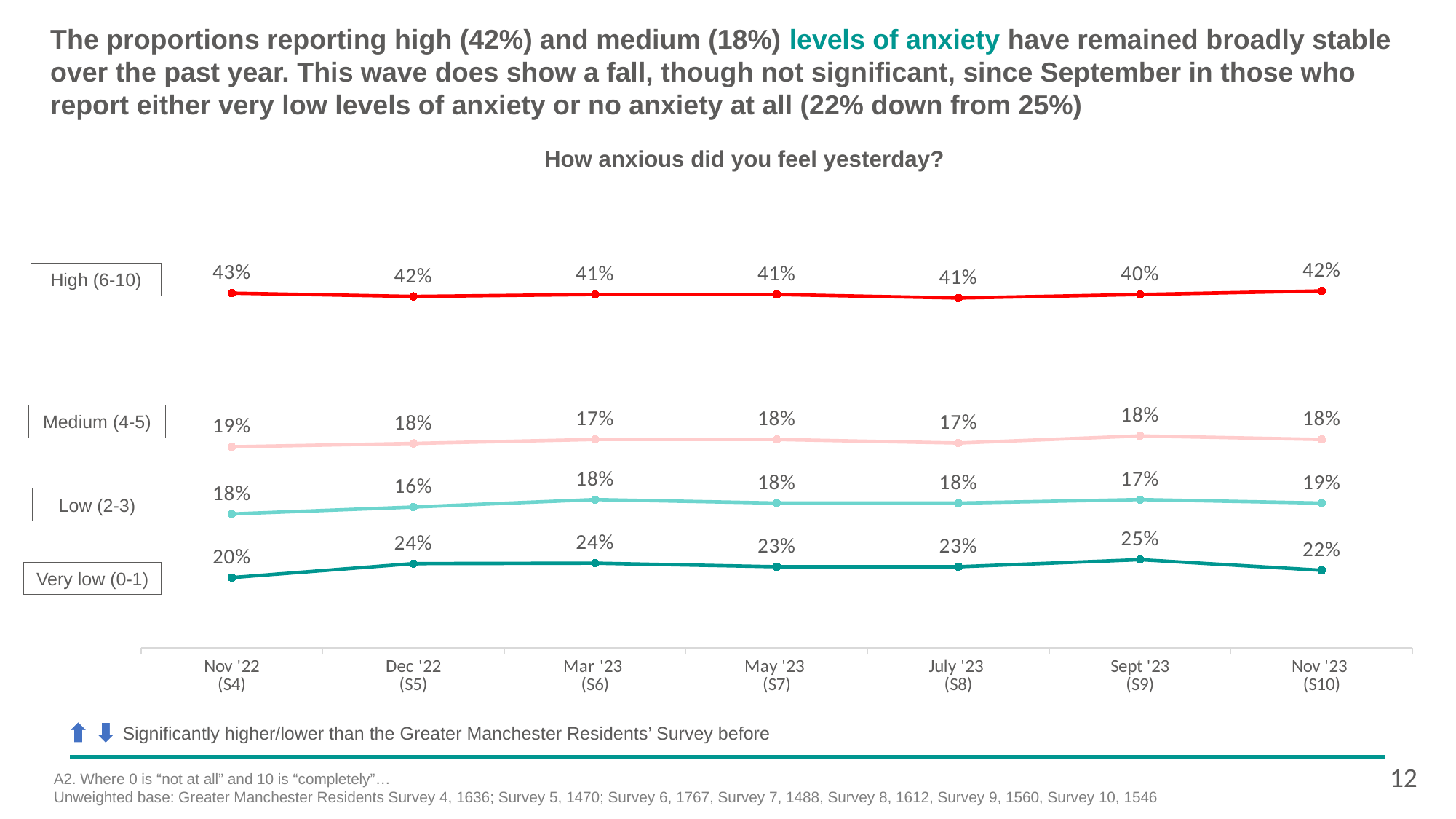
How many survey waves are shown on the x axis? 7 In which survey wave was the High (6-10) series at its lowest value? Sept '23 (S9) In which survey wave was the Very low (0-1) series at its highest value? Sept '23 (S9) Which is larger in Nov '22 (S4): the Very low (0-1) value or the Low (2-3) value? Very low (0-1) What percentage reported Low (2-3) anxiety in Dec '22 (S5)? 16% What type of chart is shown? Line chart How many series are plotted on the chart? 4 What percentage reported Very low (0-1) anxiety in Sept '23 (S9)? 25% What percentage reported High (6-10) anxiety in Nov '22 (S4)? 43% What percentage reported Medium (4-5) anxiety in Nov '23 (S10)? 18% What is the title of the chart? How anxious did you feel yesterday? What is the difference between the Very low (0-1) values in Sept '23 (S9) and Nov '23 (S10)? 3 percentage points